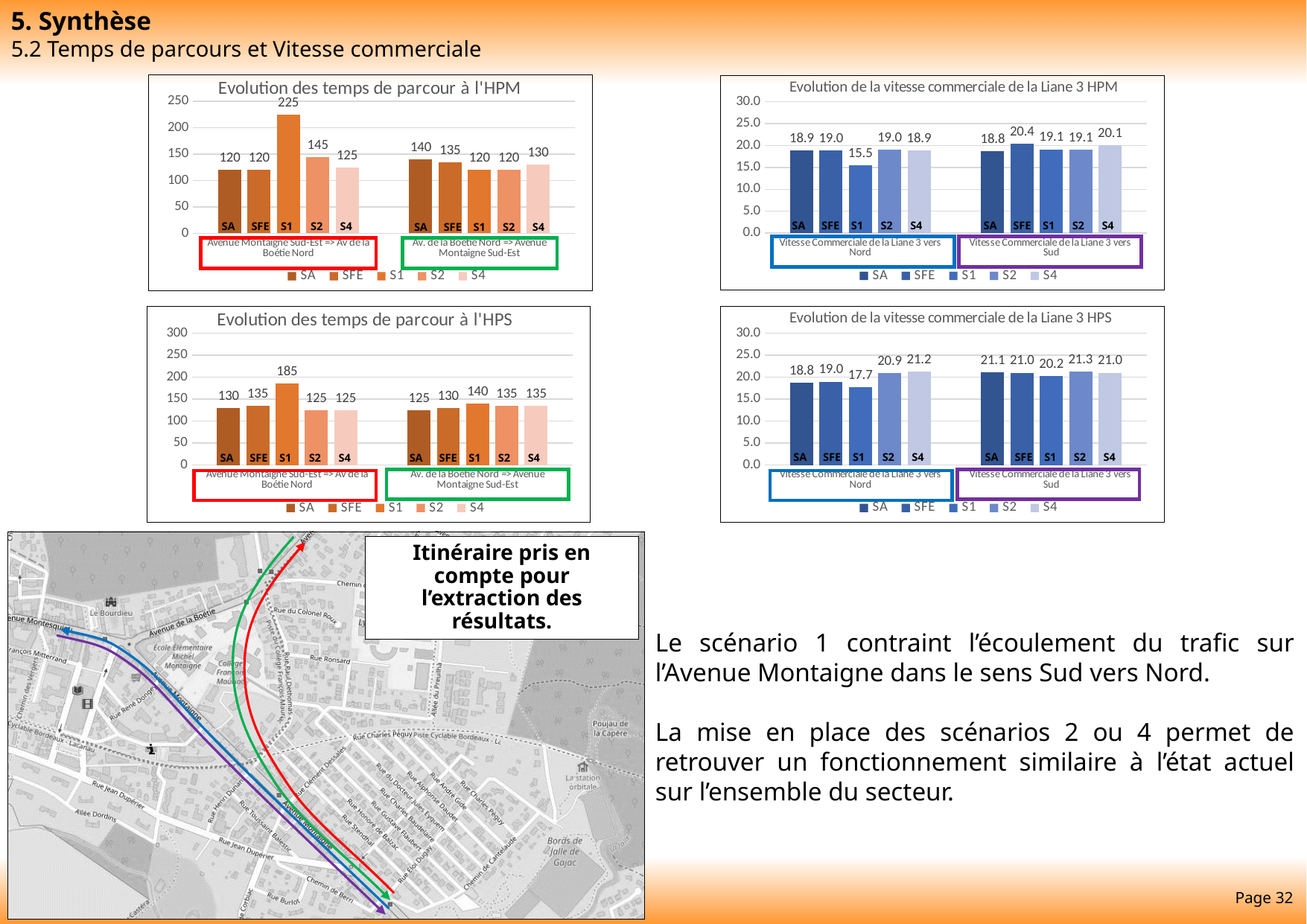
In the chart 'Evolution de la vitesse commerciale de la Liane 3 HPM', what is the value for S1 for Vitesse Commerciale de la Liane 3 vers Nord? 15.5 In the chart 'Evolution des temps de parcour à l'HPM', which scenario has the highest value on the route Avenue Montaigne Sud-Est => Av de la Boétie Nord? S1 In the chart 'Evolution de la vitesse commerciale de la Liane 3 HPM', which scenario has the highest value for Vitesse Commerciale de la Liane 3 vers Sud? SFE How many series does the legend of the chart 'Evolution des temps de parcour à l'HPS' list? 5 In the chart 'Evolution des temps de parcour à l'HPS', what is the value for S2 on the route Av. de la Boétie Nord => Avenue Montaigne Sud-Est? 135 In the chart 'Evolution des temps de parcour à l'HPM', what is the difference between S1 and SA on the route Avenue Montaigne Sud-Est => Av de la Boétie Nord? 105 In the chart 'Evolution des temps de parcour à l'HPS', what is the value for S1 on the route Avenue Montaigne Sud-Est => Av de la Boétie Nord? 185 In the chart 'Evolution de la vitesse commerciale de la Liane 3 HPS', what is the value for S4 for Vitesse Commerciale de la Liane 3 vers Nord? 21.2 In the chart 'Evolution de la vitesse commerciale de la Liane 3 HPS', which is larger for Vitesse Commerciale de la Liane 3 vers Nord: S1 or S2? S2 In the chart 'Evolution de la vitesse commerciale de la Liane 3 HPM', which scenario has the lowest value for Vitesse Commerciale de la Liane 3 vers Nord? S1 What kind of chart is 'Evolution de la vitesse commerciale de la Liane 3 HPS'? Bar chart In the chart 'Evolution des temps de parcour à l'HPM', what is the value for S1 on the route Avenue Montaigne Sud-Est => Av de la Boétie Nord? 225